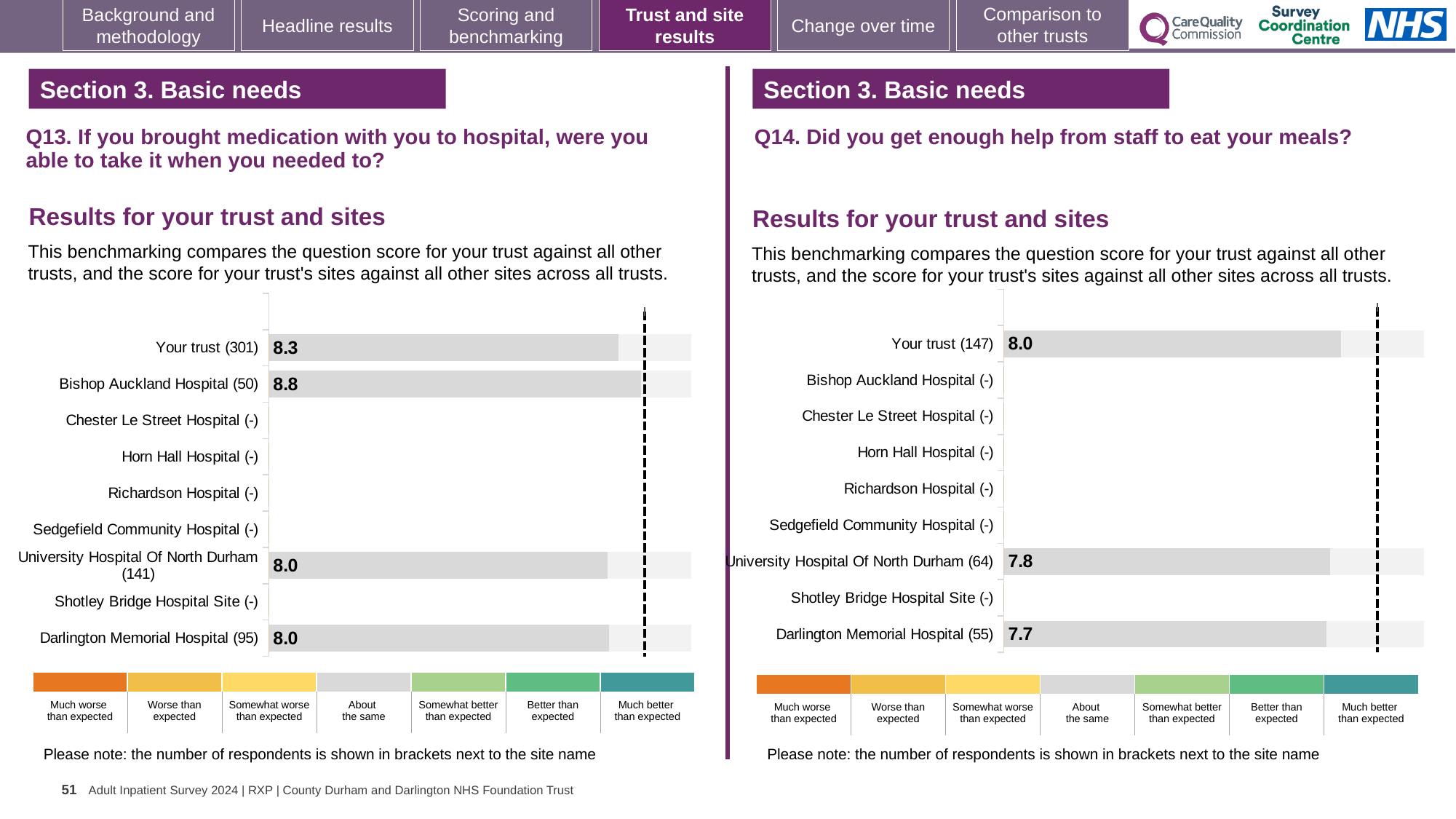
In the Q13 chart on the left, which is larger: the score for Your trust (301) or the score for Darlington Memorial Hospital (95)? Your trust (301) In the Q14 chart on the right, what is the score for University Hospital Of North Durham (64)? 7.8 What kind of chart is used for the Q13 results on the left? Bar chart In the Q13 chart on the left, what is the difference between the scores for Bishop Auckland Hospital (50) and University Hospital Of North Durham (141)? 0.8 In the Q13 chart on the left, what is the score for Your trust (301)? 8.3 In the Q13 chart on the left, which site has the highest score? Bishop Auckland Hospital (50) In the Q14 chart on the right, what is the score for Darlington Memorial Hospital (55)? 7.7 In the Q14 chart on the right, what is the score for Your trust (147)? 8.0 In the Q13 chart on the left, what is the score for Bishop Auckland Hospital (50)? 8.8 In the Q14 chart on the right, what is the difference between the scores for Your trust (147) and Darlington Memorial Hospital (55)? 0.3 In the Q14 chart on the right, which site has the lowest score among those with a bar shown? Darlington Memorial Hospital (55) In the Q13 chart on the left, what is the score for Darlington Memorial Hospital (95)? 8.0